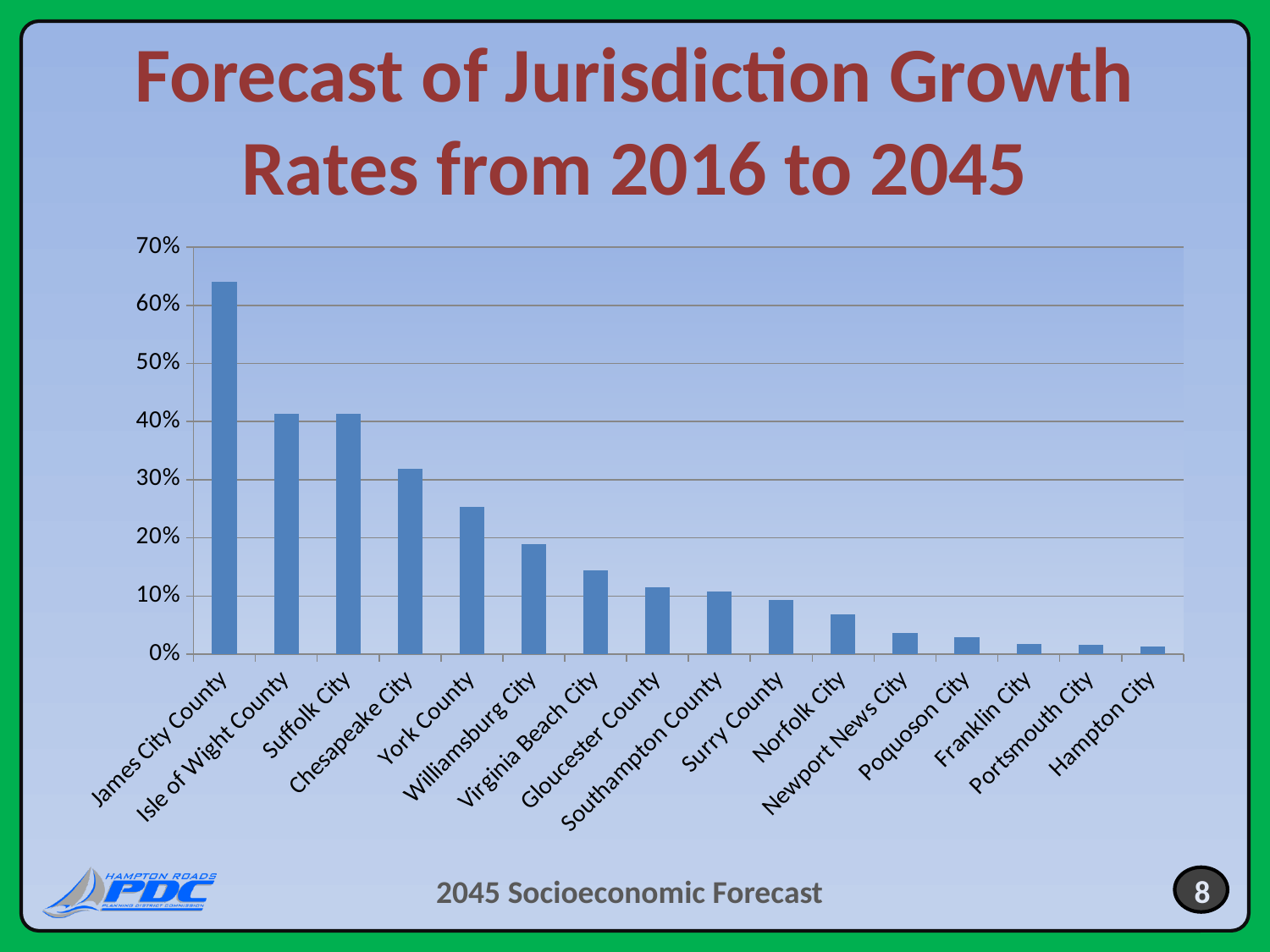
What kind of chart is shown on the slide? bar chart Is the value for Chesapeake City greater or less than 30%? greater Which has the larger forecast growth rate, Chesapeake City or York County? Chesapeake City What is the title of the chart on the slide? Forecast of Jurisdiction Growth Rates from 2016 to 2045 Is the value for Virginia Beach City greater or less than 10%? greater Is the value for Norfolk City greater or less than 10%? less Which jurisdiction has the highest forecast growth rate? James City County Do the growth rates rise or fall moving from left to right along the x axis? fall How many jurisdictions are shown on the x axis of the chart? 16